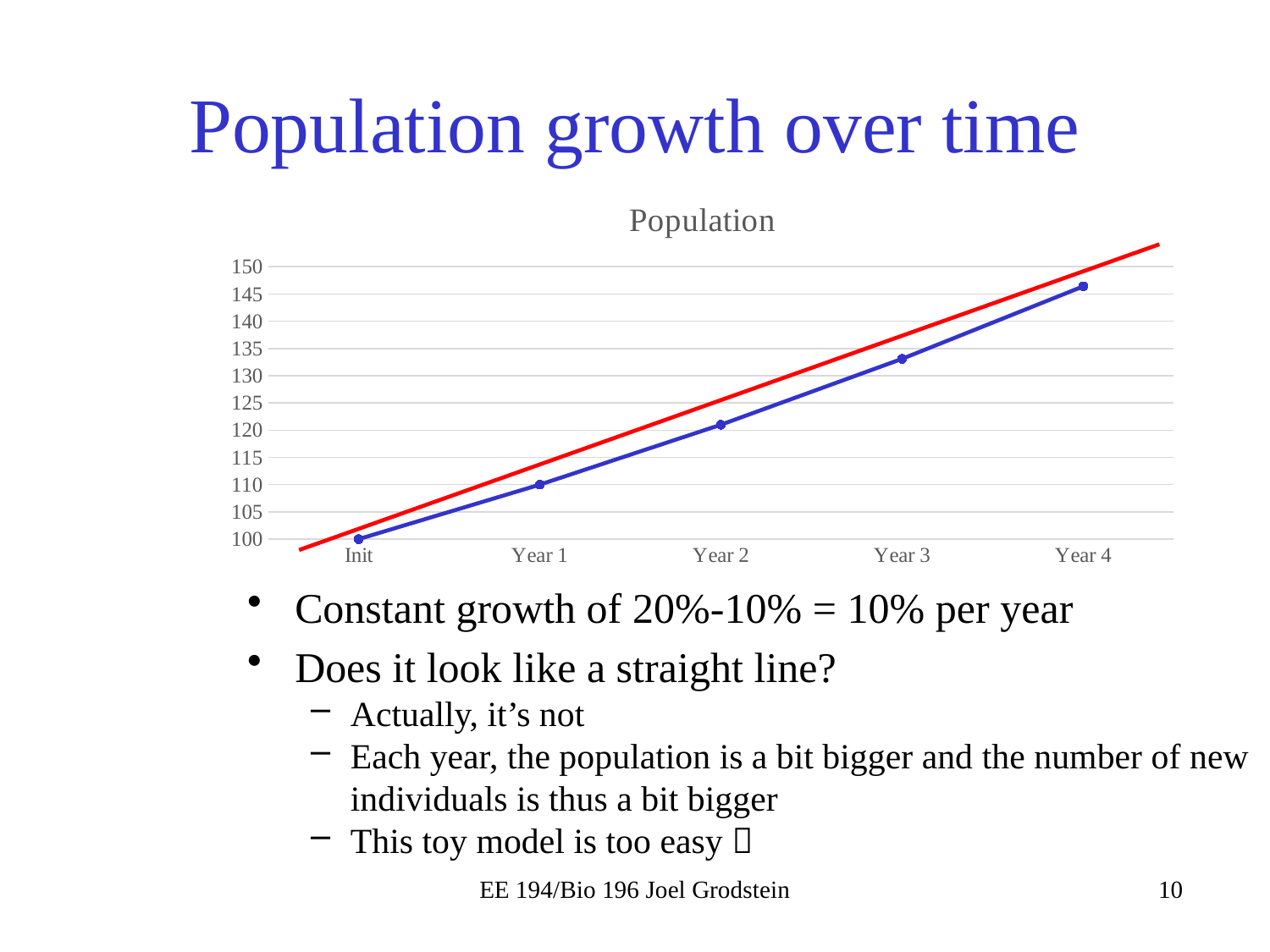
What kind of chart is shown on the slide? line chart Is the population value for Year 4 greater or less than 145? greater What is the title of the chart? Population What is the population value at Year 1? 110 Which x-axis category has the highest population value? Year 4 Do the plotted population values rise or fall from Init to Year 4? rise How many points are plotted along the x axis of the chart? 5 Is the population value for Year 3 greater or less than 135? less Which x-axis category has the lowest population value? Init What is the population value at Init? 100 Which is larger, the population value at Year 3 or at Year 2? Year 3